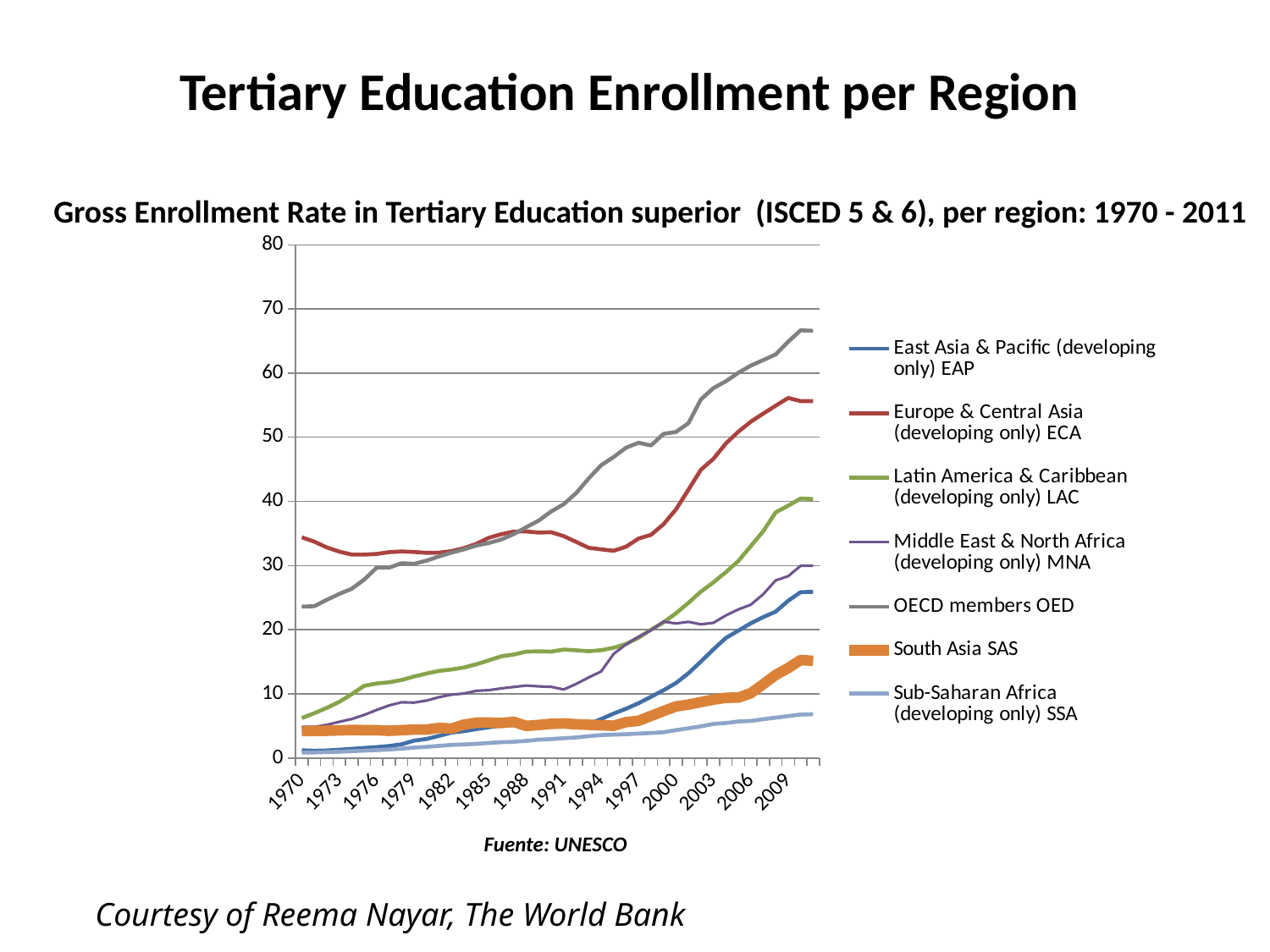
How many series does the legend list? 7 Is the value for Sub-Saharan Africa (developing only) SSA in 2011 greater or less than 10? less In 1970, which region has the higher enrollment rate: Europe & Central Asia ECA or OECD members OED? Europe & Central Asia (developing only) ECA What kind of chart is shown on the slide? line chart Which series is drawn with the thick orange line? South Asia SAS Is the value for OECD members OED in 2009 greater or less than 60? greater Does the enrollment rate for OECD members OED generally rise or fall from 1970 to 2011? rise Which region has the lowest gross enrollment rate at the end of the period (2011)? Sub-Saharan Africa (developing only) SSA Which region has the highest gross enrollment rate at the end of the period (2011)? OECD members OED What source is cited below the chart? UNESCO In 2011, which region has the higher enrollment rate: Latin America & Caribbean LAC or Middle East & North Africa MNA? Latin America & Caribbean (developing only) LAC Is the value for Europe & Central Asia (developing only) ECA in 1970 greater or less than 30? greater